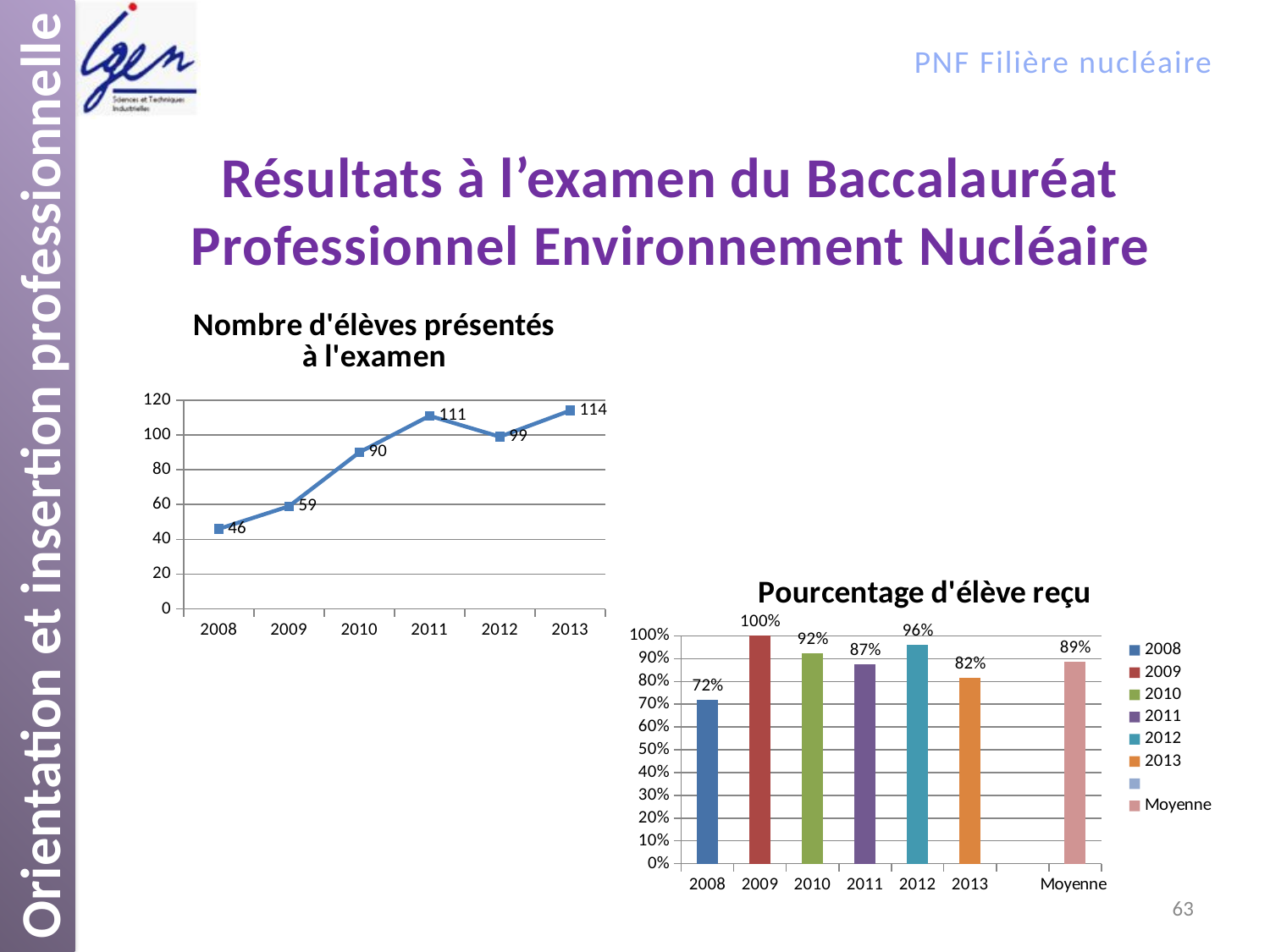
What type of chart is 'Pourcentage d'élève reçu'? Bar chart What type of chart is 'Nombre d'élèves présentés à l'examen'? Line chart In the chart 'Nombre d'élèves présentés à l'examen', which year has the lowest number of students presented? 2008 In the chart 'Nombre d'élèves présentés à l'examen', how many students were presented in 2011? 111 In the chart 'Pourcentage d'élève reçu', which category has the lowest value? 2008 In the chart 'Pourcentage d'élève reçu', which is larger, the value for 2012 or the value for 2013? 2012 In the chart 'Pourcentage d'élève reçu', what is the value for Moyenne? 89% In the chart 'Nombre d'élèves présentés à l'examen', how many years are shown on the x axis? 6 In the chart 'Nombre d'élèves présentés à l'examen', what is the difference between the values for 2010 and 2009? 31 In the chart 'Nombre d'élèves présentés à l'examen', which year has the highest number of students presented? 2013 In the chart 'Nombre d'élèves présentés à l'examen', does the value rise or fall from 2011 to 2012? Fall In the chart 'Pourcentage d'élève reçu', what is the value for 2009? 100%